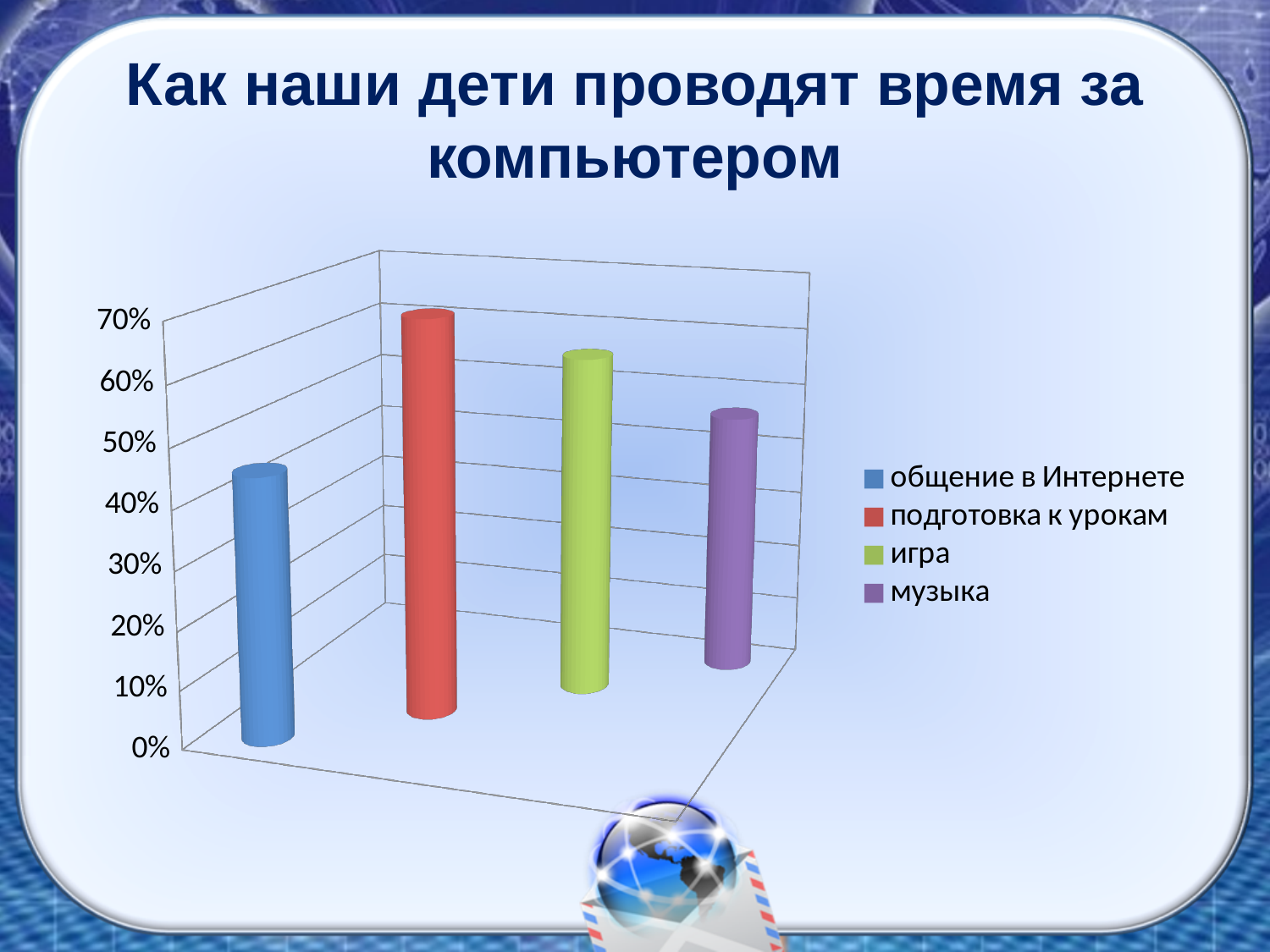
What is the title of the chart on the slide? Как наши дети проводят время за компьютером Is the value for подготовка к урокам greater or less than 60%? greater Is the value for общение в Интернете greater or less than 60%? less How many entries does the legend list? 4 What colour is the bar for игра? green Which category has the highest bar? подготовка к урокам What kind of chart is shown on the slide? bar chart Which category has the lowest bar? общение в Интернете Which is larger, the value for игра or the value for музыка? игра Is the value for игра greater or less than 50%? greater How many bars are plotted in the chart? 4 Which is larger, the value for подготовка к урокам or the value for общение в Интернете? подготовка к урокам